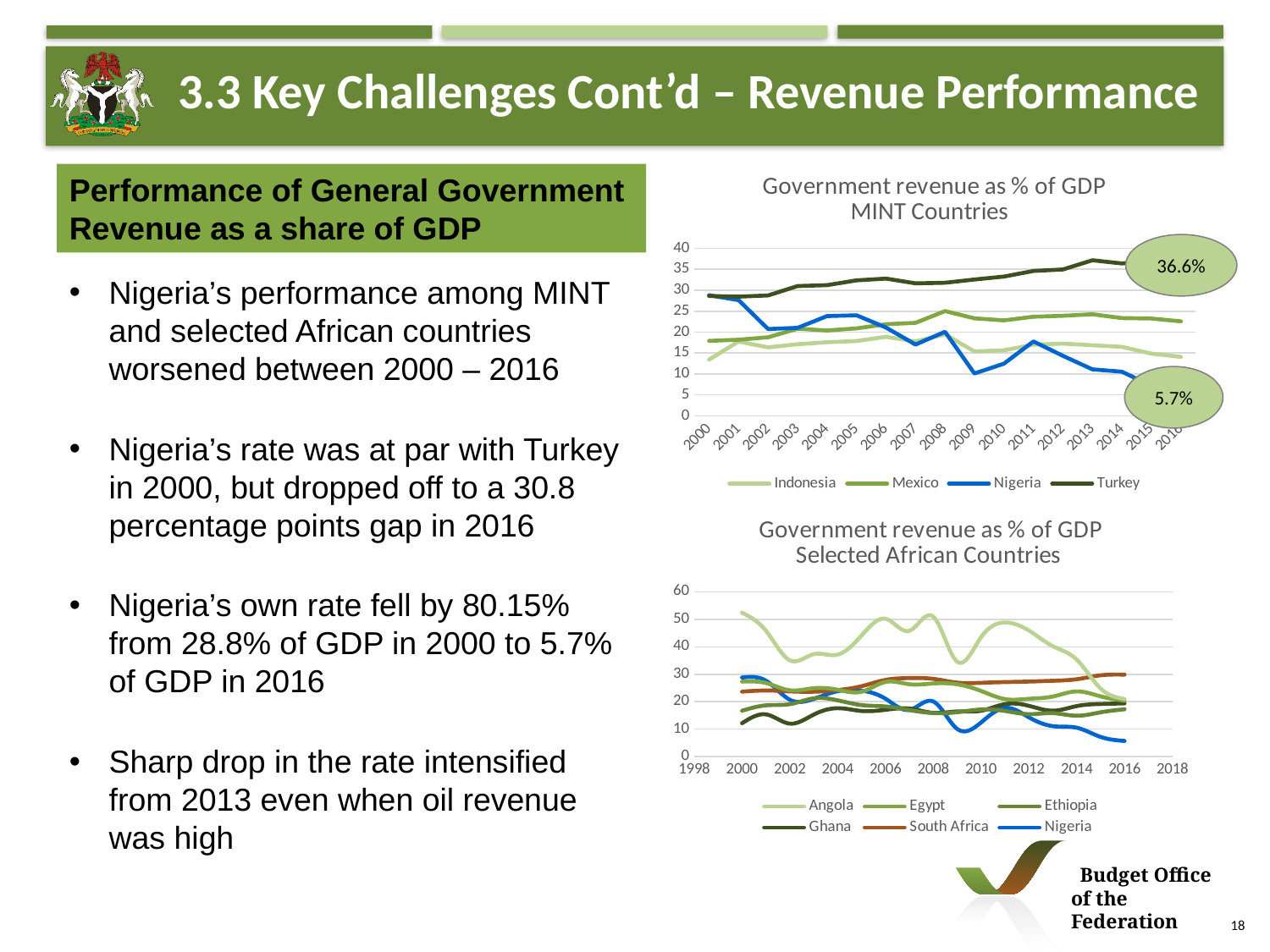
What kind of chart is the 'Government revenue as % of GDP MINT Countries' chart? line chart Which countries are listed in the legend of the 'Government revenue as % of GDP MINT Countries' chart? Indonesia, Mexico, Nigeria, Turkey In the 'Government revenue as % of GDP Selected African Countries' chart, is the value for Angola in 2008 greater or less than 40? greater In the 'Government revenue as % of GDP MINT Countries' chart, what value is labelled for Turkey in 2016? 36.6% How many series does the legend of the 'Government revenue as % of GDP MINT Countries' chart list? 4 How many series does the legend of the 'Government revenue as % of GDP Selected African Countries' chart list? 6 In the 'Government revenue as % of GDP MINT Countries' chart, which country has the lowest value in 2016? Nigeria In the 'Government revenue as % of GDP MINT Countries' chart, what value is labelled for Nigeria in 2016? 5.7% In the 'Government revenue as % of GDP MINT Countries' chart, does the Nigeria line generally rise or fall from 2000 to 2016? fall In the 'Government revenue as % of GDP Selected African Countries' chart, which is larger in 2016, South Africa or Nigeria? South Africa In the 'Government revenue as % of GDP MINT Countries' chart, does the Turkey line generally rise or fall from 2000 to 2016? rise In the 'Government revenue as % of GDP MINT Countries' chart, which country has the highest value in 2016? Turkey